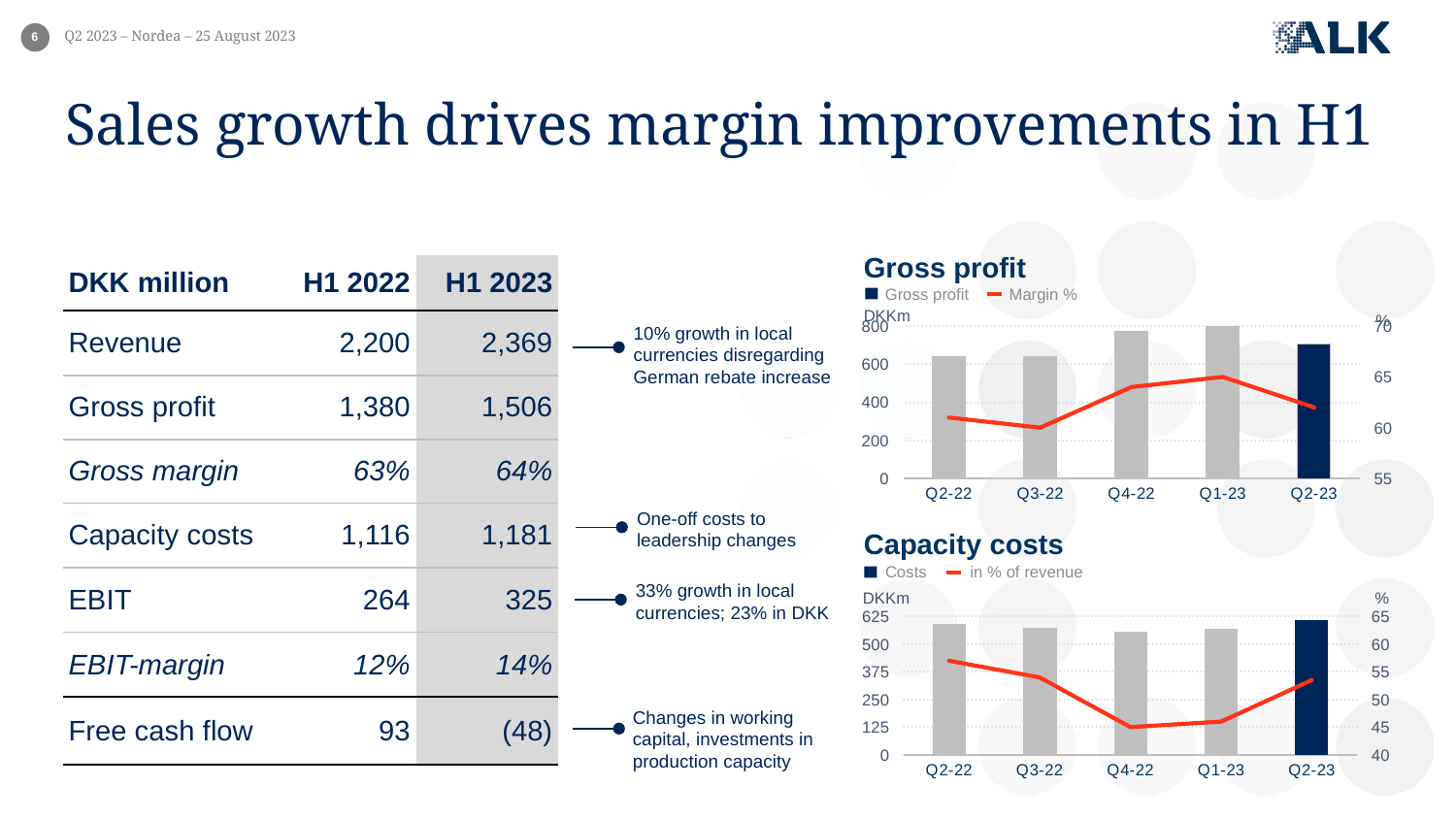
In the Gross profit chart, is the gross profit bar for Q2-22 greater or less than 600 DKKm? greater In the Gross profit chart, what are the two legend entries? Gross profit and Margin % In the Capacity costs chart, in which quarter is the 'in % of revenue' line at its highest? Q2-22 In the Gross profit chart, how many quarters are shown on the x axis? 5 In the Capacity costs chart, is the 'in % of revenue' value for Q4-22 greater or less than 50%? less In the Gross profit chart, in which quarter is the Margin % line at its highest? Q1-23 In the Gross profit chart, how many series does the legend list? 2 In the Capacity costs chart, does the 'in % of revenue' line rise or fall from Q2-22 to Q4-22? fall In the Gross profit chart, is the gross profit bar for Q2-23 greater or less than 800 DKKm? less In the Capacity costs chart, how many series does the legend list? 2